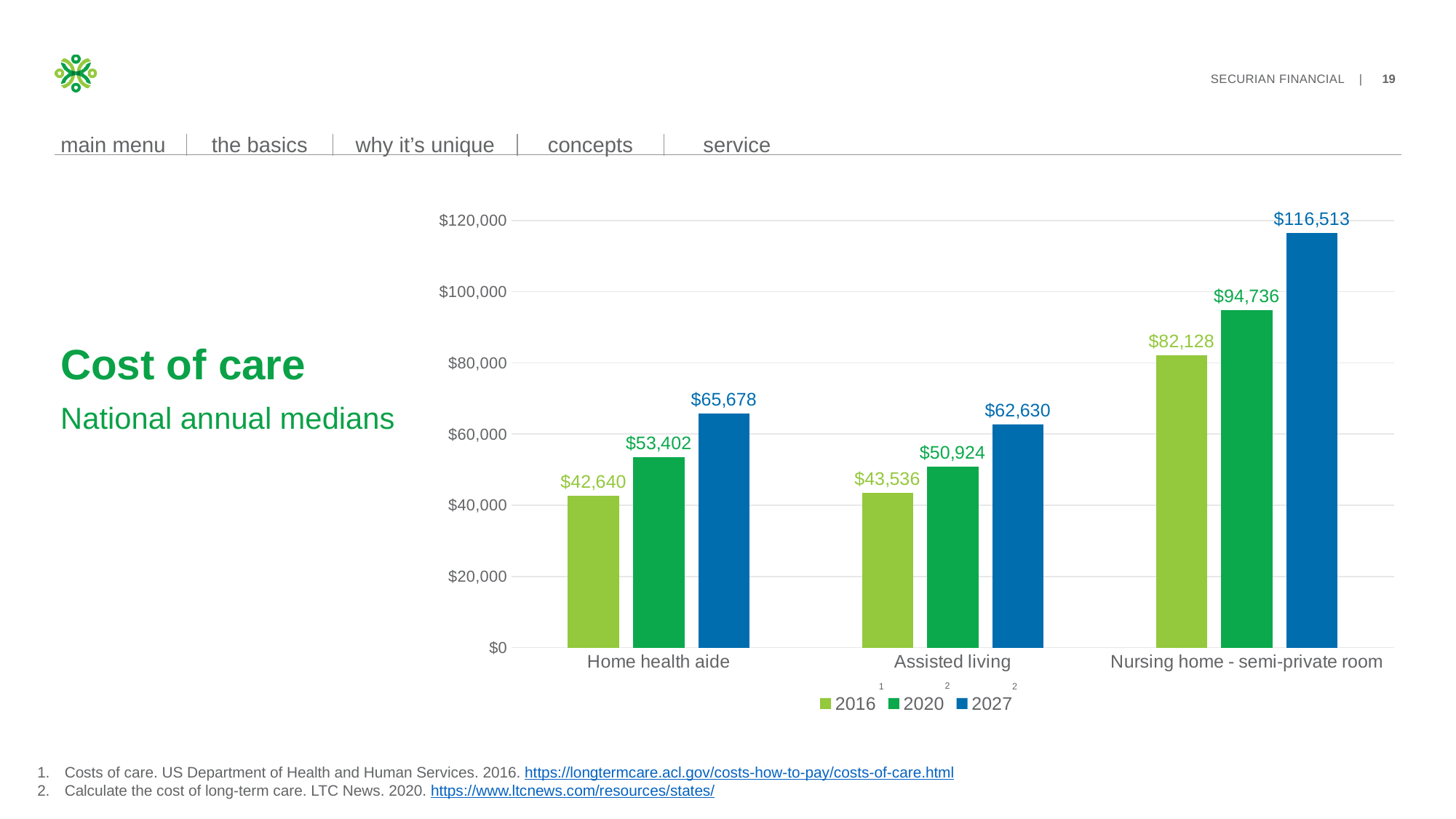
What is the 2020 value for Assisted living? $50,924 Which is larger, the 2027 value for Home health aide or the 2027 value for Assisted living? Home health aide What is the 2027 value for Nursing home - semi-private room? $116,513 How many series does the legend list? 3 How many categories are shown on the x axis? 3 Which category has the lowest 2016 value? Home health aide What is the difference between the 2027 and 2016 values for Nursing home - semi-private room? $34,385 What is the difference between the 2020 values for Home health aide and Assisted living? $2,478 Which series is shown in dark blue in the legend? 2027 What is the 2016 value for Home health aide? $42,640 What kind of chart is shown on the slide? Bar chart Which category has the highest 2027 value? Nursing home - semi-private room